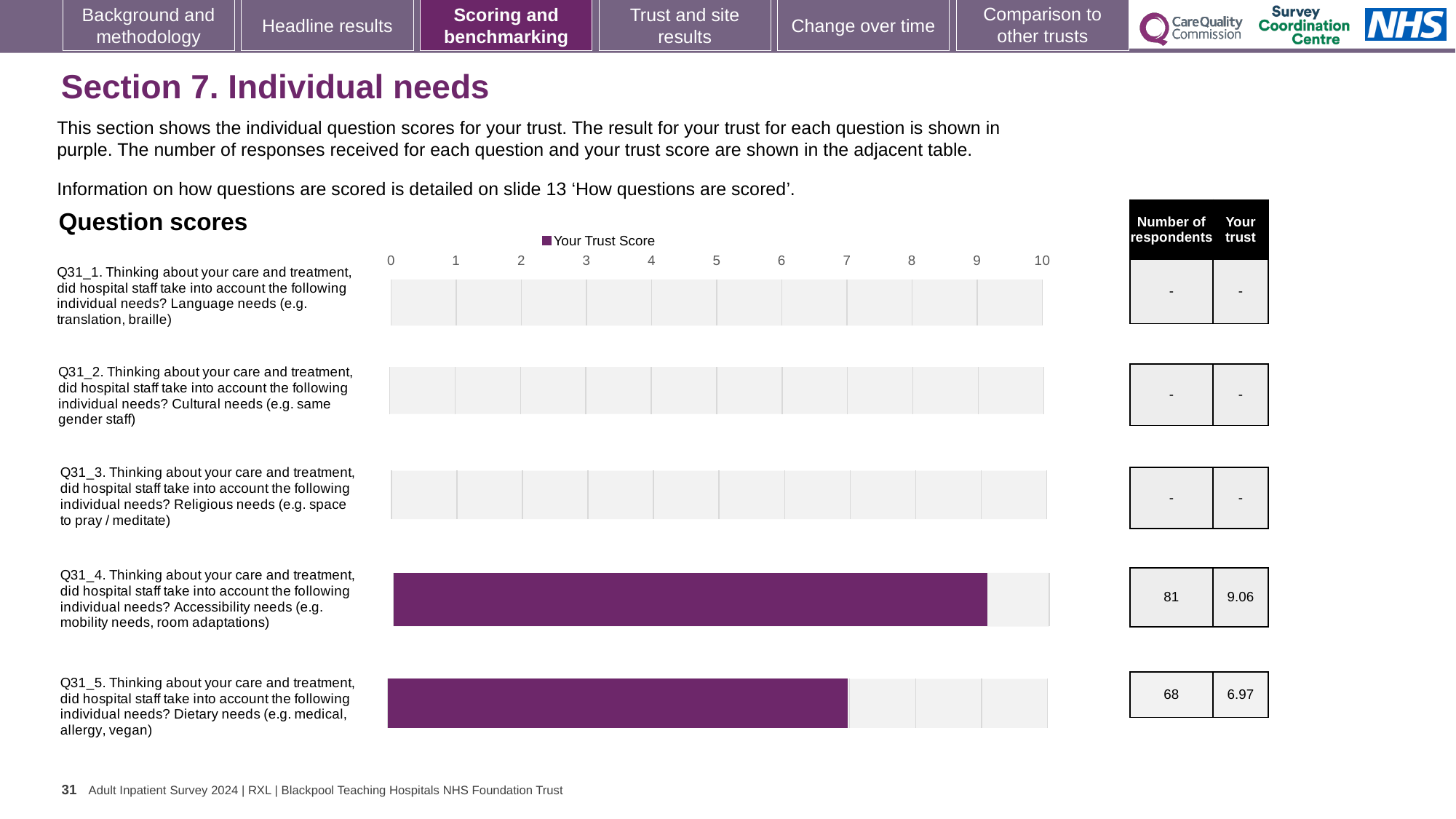
How many respondents answered Q31_4 (Accessibility needs)? 81 What is the difference between the trust scores for Q31_4 and Q31_5? 2.09 Which question has the highest trust score shown on the chart? Q31_4 (Accessibility needs) How many questions are listed on the chart? 5 What is the trust score for Q31_4 (Accessibility needs)? 9.06 What is the trust score for Q31_5 (Dietary needs)? 6.97 Is the trust score for Q31_4 (Accessibility needs) greater or less than 9? greater What type of chart is shown on the slide? Bar chart What series name is shown in the chart legend? Your Trust Score How many respondents answered Q31_5 (Dietary needs)? 68 Which has the larger trust score, Q31_4 (Accessibility needs) or Q31_5 (Dietary needs)? Q31_4 (Accessibility needs) Is the trust score for Q31_5 (Dietary needs) greater or less than 8? less